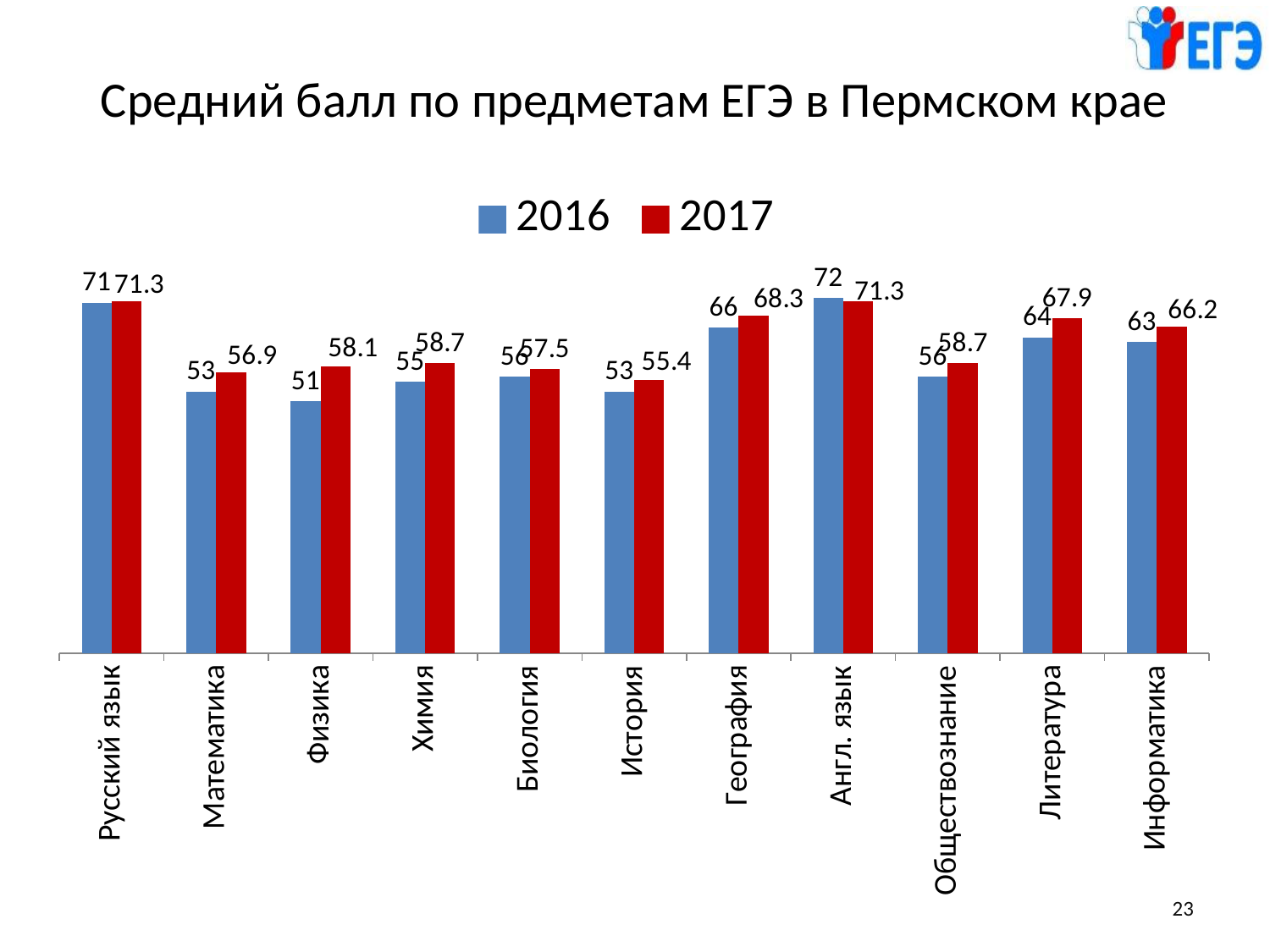
What type of chart is shown on the slide? bar chart How many subjects (categories) are shown on the x axis? 11 Which subject has the highest 2016 value? Англ. язык What is the 2016 value for Литература? 64 What is the title of the chart? Средний балл по предметам ЕГЭ в Пермском крае What is the difference between the 2017 and 2016 values for Физика? 7.1 Which subject has the lowest 2016 value? Физика What is the 2017 value for Информатика? 66.2 How many series does the legend list? 2 Which is larger for Англ. язык, the 2016 value or the 2017 value? 2016 Which subject has the lowest 2017 value? История What is the 2017 value for Физика? 58.1